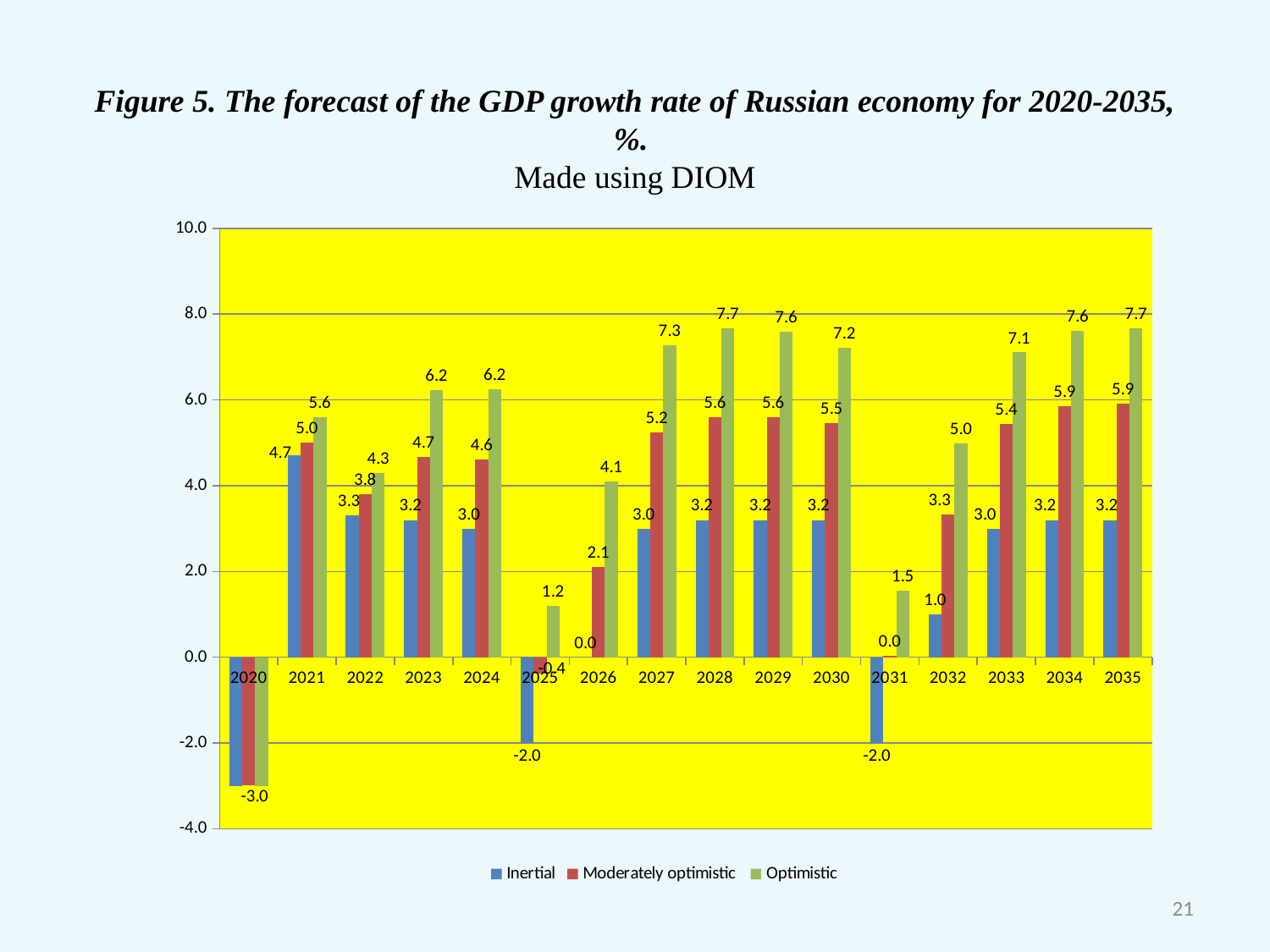
In which year is the Inertial series at its lowest value? 2020 What kind of chart is shown on the slide? bar chart How many series does the legend list? 3 What is the Optimistic value for 2027? 7.3 How many years are shown on the x axis? 16 What is the Inertial value for 2021? 4.7 What is the difference between the Optimistic and Inertial values in 2023? 3.0 Is the Optimistic value for 2028 greater or less than 6.0? greater What is the Moderately optimistic value for 2032? 3.3 Which is larger: the Optimistic value for 2026 or the Optimistic value for 2032? 2032 Does the Optimistic series rise or fall from 2031 to 2035? rise What are the three series named in the legend? Inertial, Moderately optimistic, Optimistic